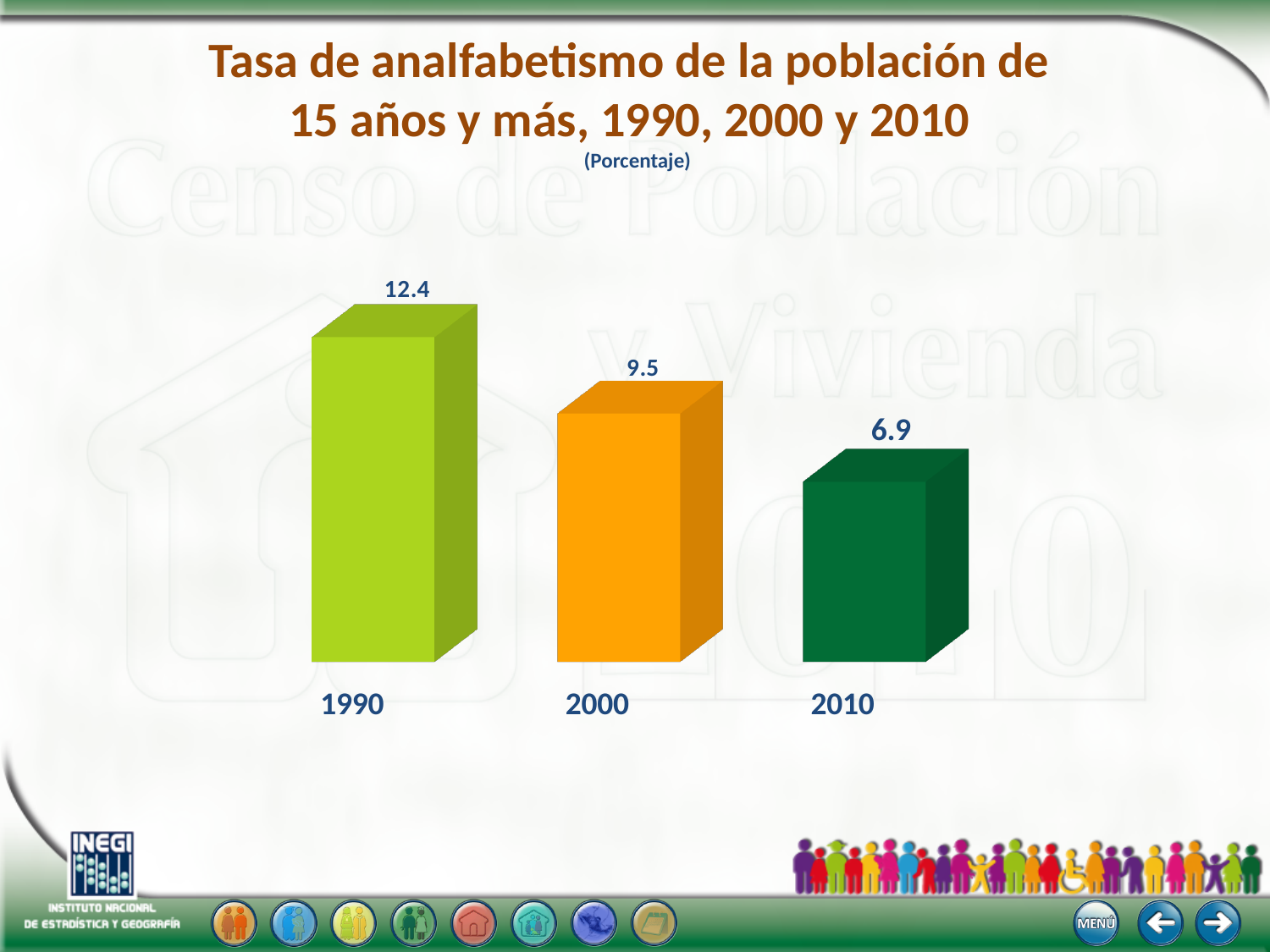
Which year has the highest illiteracy rate? 1990 What kind of chart is shown on the slide? Bar chart Do the values rise or fall from 1990 to 2010? Fall What is the difference between the illiteracy rates for 1990 and 2010? 5.5 Which year has the lowest illiteracy rate? 2010 In what unit are the values expressed, according to the subtitle? Porcentaje What is the illiteracy rate shown for 2010? 6.9 What is the illiteracy rate shown for 1990? 12.4 Which is larger, the value for 2000 or the value for 2010? 2000 What is the difference between the illiteracy rates for 2000 and 2010? 2.6 What is the illiteracy rate shown for 2000? 9.5 How many years are shown in the chart? 3